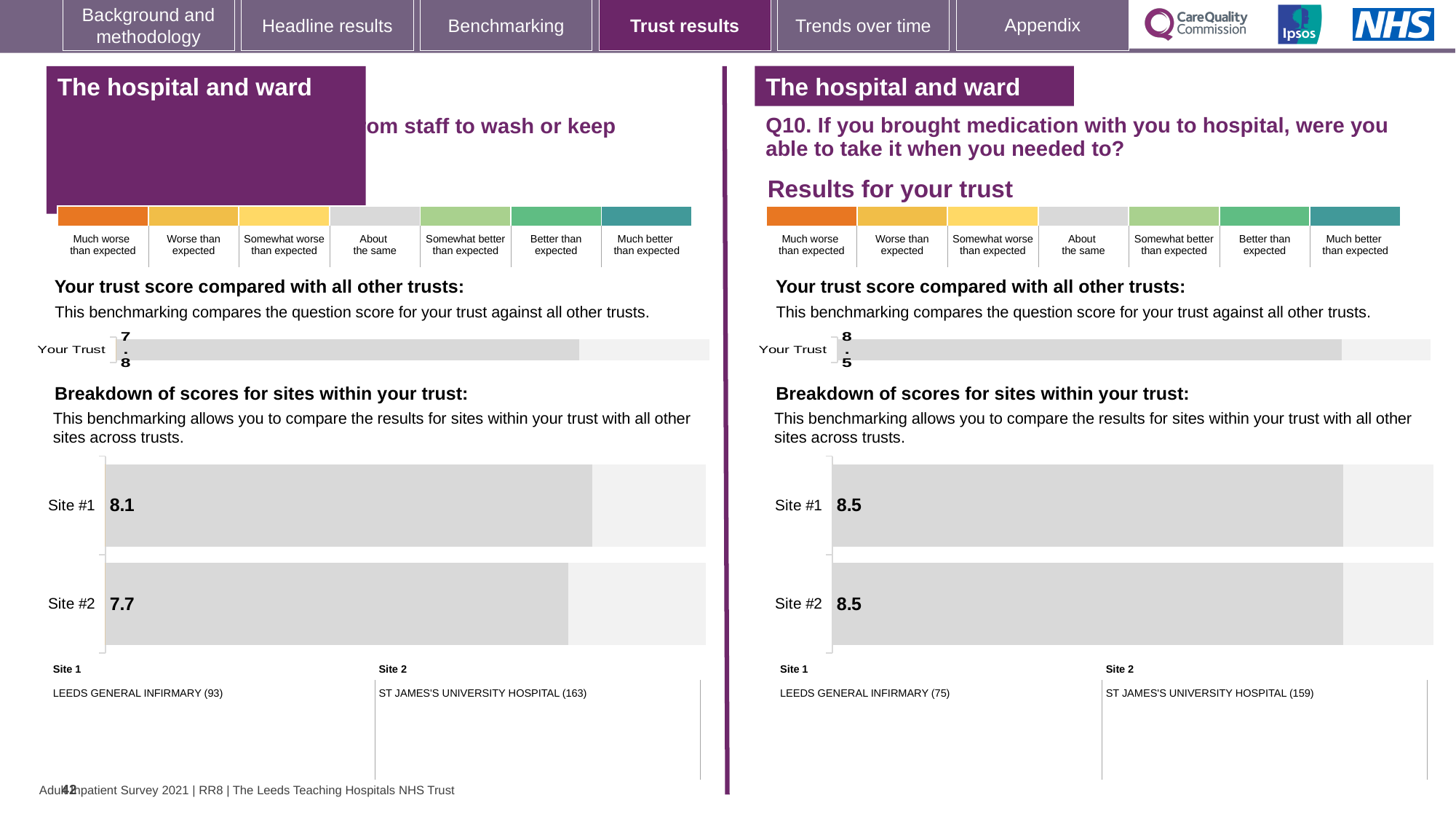
On the left-hand side of the slide, what is the difference between the Site #1 and Site #2 scores? 0.4 On the left-hand side of the slide, what is the score shown for Site #2 in the breakdown of scores for sites within your trust? 7.7 For Q10 (medication brought to hospital), what is the difference between the Site #1 and Site #2 scores? 0.0 Is the Site #2 score on the left-hand side of the slide larger or smaller than the Site #2 score for Q10 on the right-hand side? Smaller What type of chart is used for the breakdown of scores for sites within your trust on the left-hand side of the slide? Bar chart On the left-hand side of the slide, what is the score shown for Site #1 in the breakdown of scores for sites within your trust? 8.1 For Q10 (medication brought to hospital), what is the score shown for Site #2 in the site breakdown chart? 8.5 For Q10 (medication brought to hospital), what is the score shown for Site #1 in the site breakdown chart? 8.5 How many sites are shown in the site breakdown chart on the right-hand side of the slide? 2 On the left-hand side of the slide, what is the 'Your Trust' score in the trust score comparison chart? 7.8 On the left-hand side of the slide, which site has the higher score in the site breakdown chart? Site #1 For Q10 (medication brought to hospital), what is the 'Your Trust' score in the trust score comparison chart? 8.5